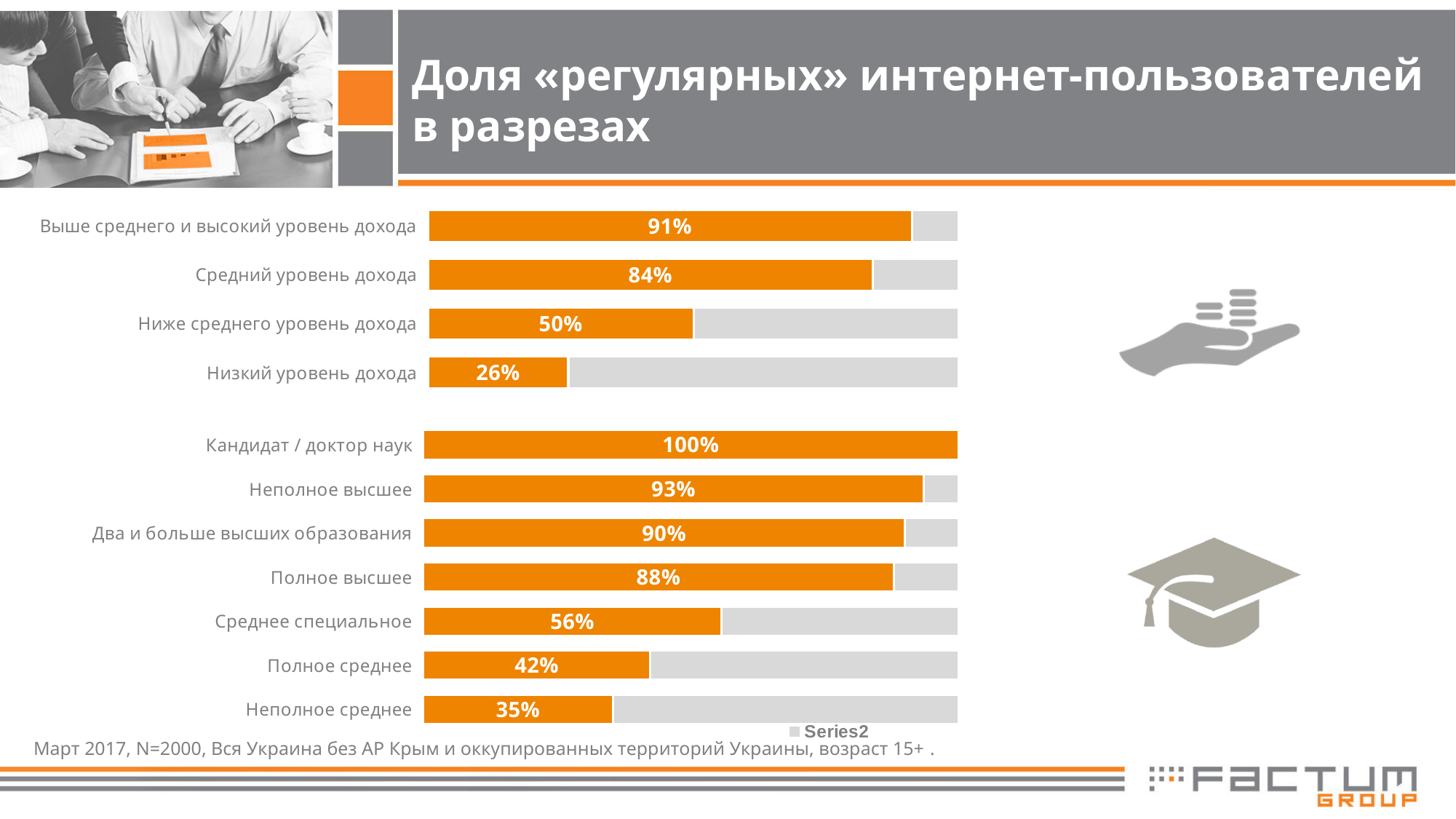
In the lower chart (education levels), what is the value for «Среднее специальное»? 56% In the lower chart (education levels), which category has the highest value? Кандидат / доктор наук What type of chart is used on this slide? Bar chart In the lower chart (education levels), which category has the lowest value? Неполное среднее In the upper chart (income levels), which category has the highest value? Выше среднего и высокий уровень дохода In the upper chart (income levels), what is the value for «Низкий уровень дохода»? 26% In the upper chart (income levels), how many categories are shown? 4 In the lower chart (education levels), what is the difference between «Полное среднее» and «Неполное среднее»? 7% In the upper chart (income levels), what is the value for «Средний уровень дохода»? 84% In the lower chart (education levels), what is the value for «Полное высшее»? 88% In the upper chart (income levels), what is the difference between «Выше среднего и высокий уровень дохода» and «Ниже среднего уровень дохода»? 41% In the lower chart (education levels), which is larger: «Неполное высшее» or «Два и больше высших образования»? Неполное высшее